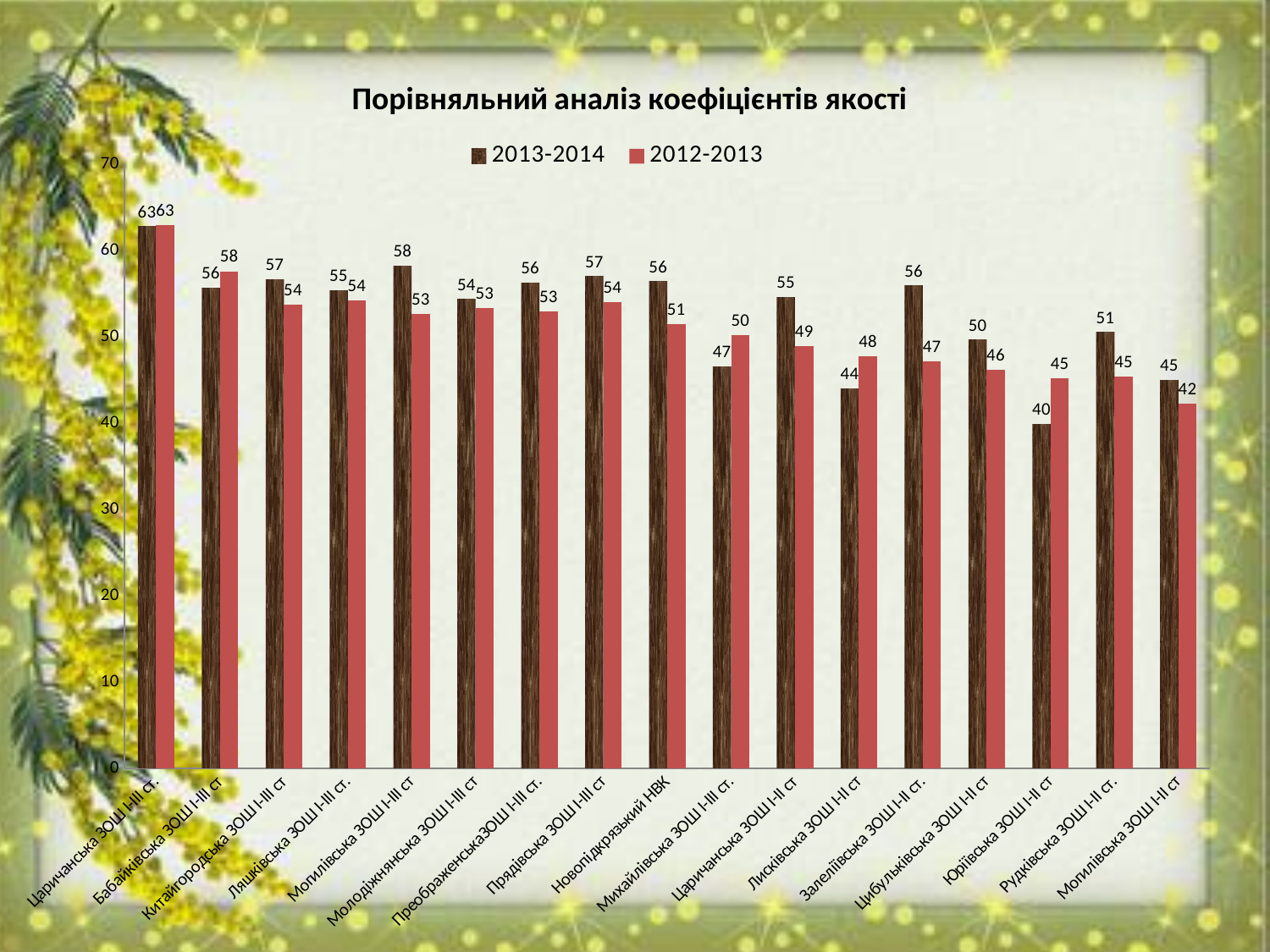
For Михайлівська ЗОШ І-ІІІ ст., which series has the larger value, 2013-2014 or 2012-2013? 2012-2013 What is the difference between the 2013-2014 and 2012-2013 values for Залелівська ЗОШ І-ІІ ст.? 9 What is the value for Новопідкрязький НВК in the 2013-2014 series? 56 How many categories are shown on the x axis? 17 What is the title of the chart? Порівняльний аналіз коефіцієнтів якості What is the value for Юріївська ЗОШ І-ІІ ст in the 2012-2013 series? 45 Which category has the highest value in the 2013-2014 series? Царичанська ЗОШ І-ІІІ ст. Which category has the lowest value in the 2013-2014 series? Юріївська ЗОШ І-ІІ ст How many series does the legend list? 2 Which category has the lowest value in the 2012-2013 series? Могилівська ЗОШ І-ІІ ст What kind of chart is shown on the slide? Bar chart What is the value for Лисківська ЗОШ І-ІІ ст in the 2013-2014 series? 44